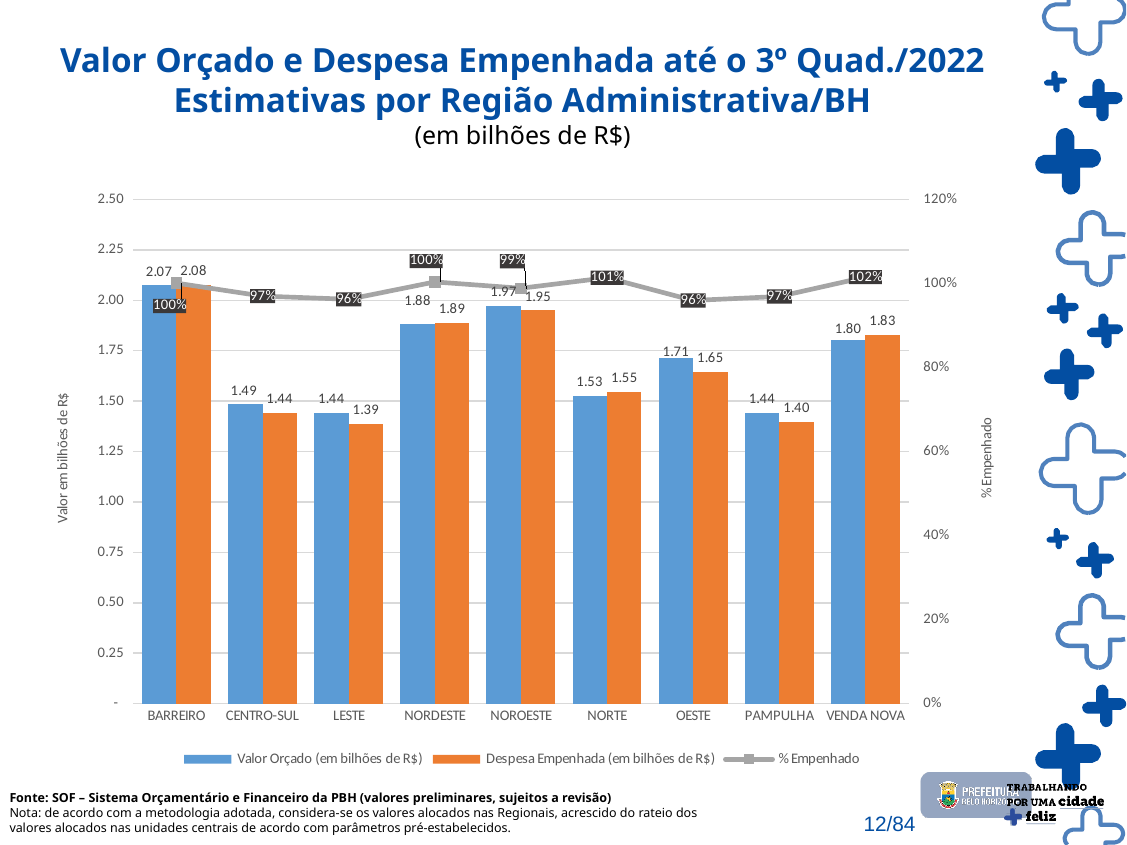
For NORTE, which is larger: Valor Orçado or Despesa Empenhada? Despesa Empenhada What kind of chart is this? bar chart with a line What is the % Empenhado for VENDA NOVA? 102% What is the Despesa Empenhada (em bilhões de R$) for OESTE? 1.65 What is the Valor Orçado (em bilhões de R$) for NORDESTE? 1.88 How many series does the legend list? 3 Which region has the highest Valor Orçado? BARREIRO Which region has the highest % Empenhado? VENDA NOVA Is the Valor Orçado for PAMPULHA greater or less than 1.50? less Which region has the lowest Despesa Empenhada? LESTE What is the difference between Valor Orçado and Despesa Empenhada for OESTE? 0.06 How many regions are shown on the x axis? 9